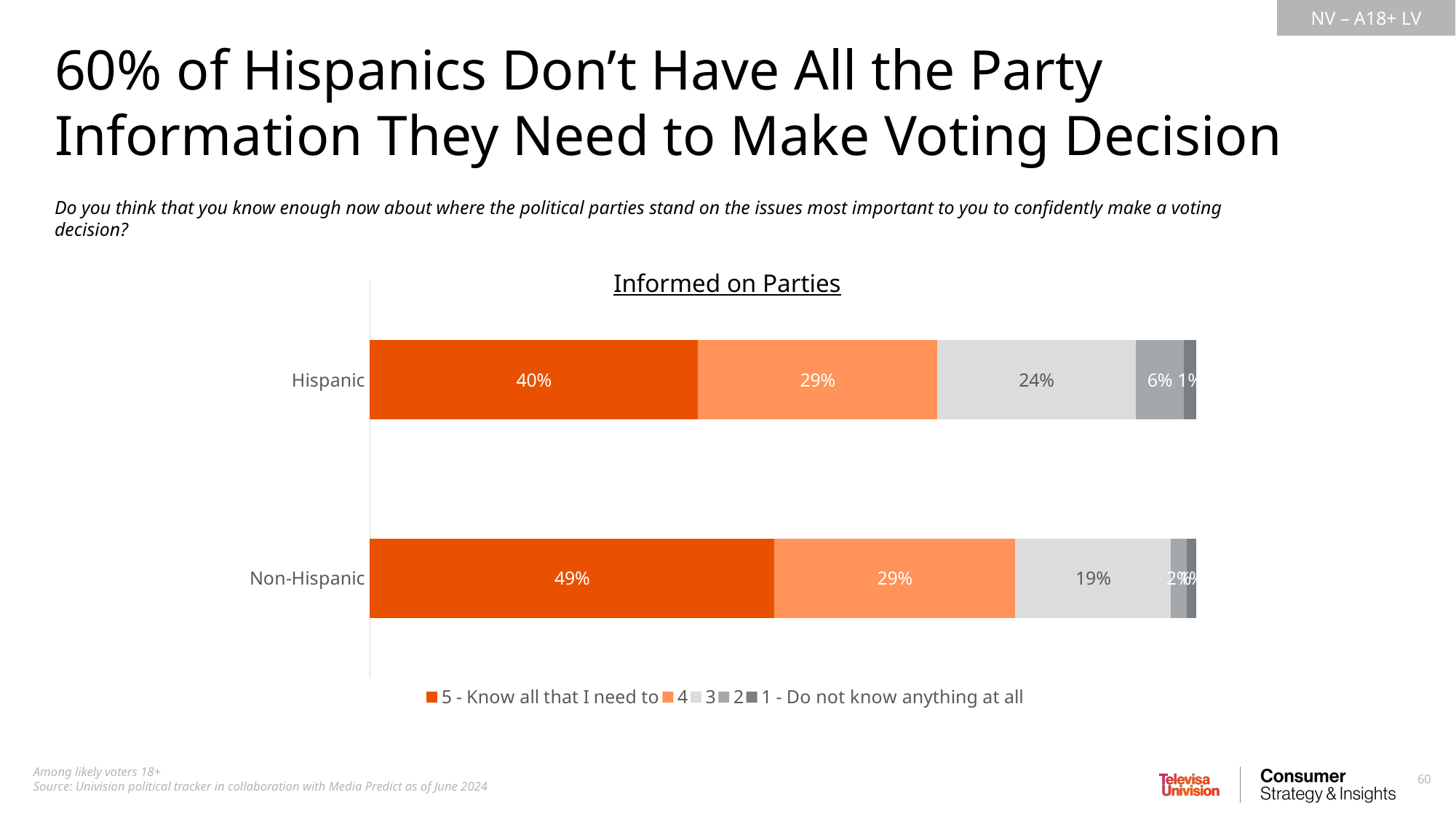
How many groups (categories) are shown in the chart? 2 What percentage of Non-Hispanic respondents chose "3"? 19% What percentage of Hispanic respondents chose "2"? 6% What is the difference between the Non-Hispanic and Hispanic shares for "5 - Know all that I need to"? 9 percentage points What percentage of Non-Hispanic respondents chose "5 - Know all that I need to"? 49% How many series does the legend list? 5 What percentage of Hispanic respondents chose "3"? 24% What type of chart is shown on the slide? Stacked bar chart What is the difference between the Hispanic and Non-Hispanic shares for "3"? 5 percentage points What percentage of Hispanic respondents chose "1 - Do not know anything at all"? 1% What percentage of Hispanic respondents chose "5 - Know all that I need to"? 40% Which group has the larger share for "5 - Know all that I need to", Hispanic or Non-Hispanic? Non-Hispanic